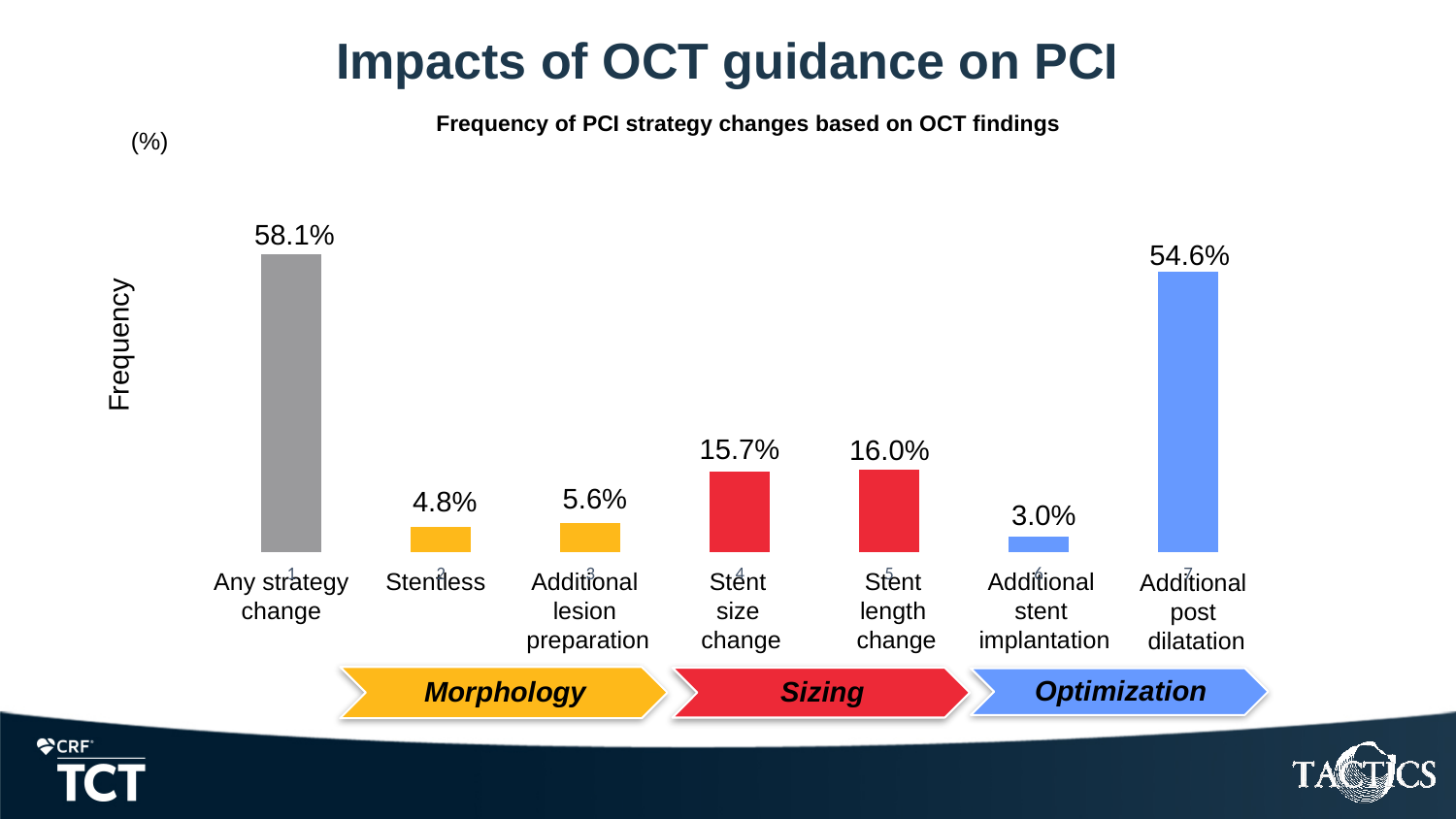
What is the difference between Any strategy change and Additional post dilatation? 3.5% What is the value for Additional post dilatation? 54.6% What is the difference between Stent length change and Stent size change? 0.3% What kind of chart is this? Bar chart What is the title of the chart? Frequency of PCI strategy changes based on OCT findings How many categories are shown in the chart? 7 Which category has the highest value? Any strategy change What is the value for Any strategy change? 58.1% What is the value for Stent length change? 16.0% Which is larger, Stentless or Additional lesion preparation? Additional lesion preparation Which category has the lowest value? Additional stent implantation What is the value for Additional stent implantation? 3.0%